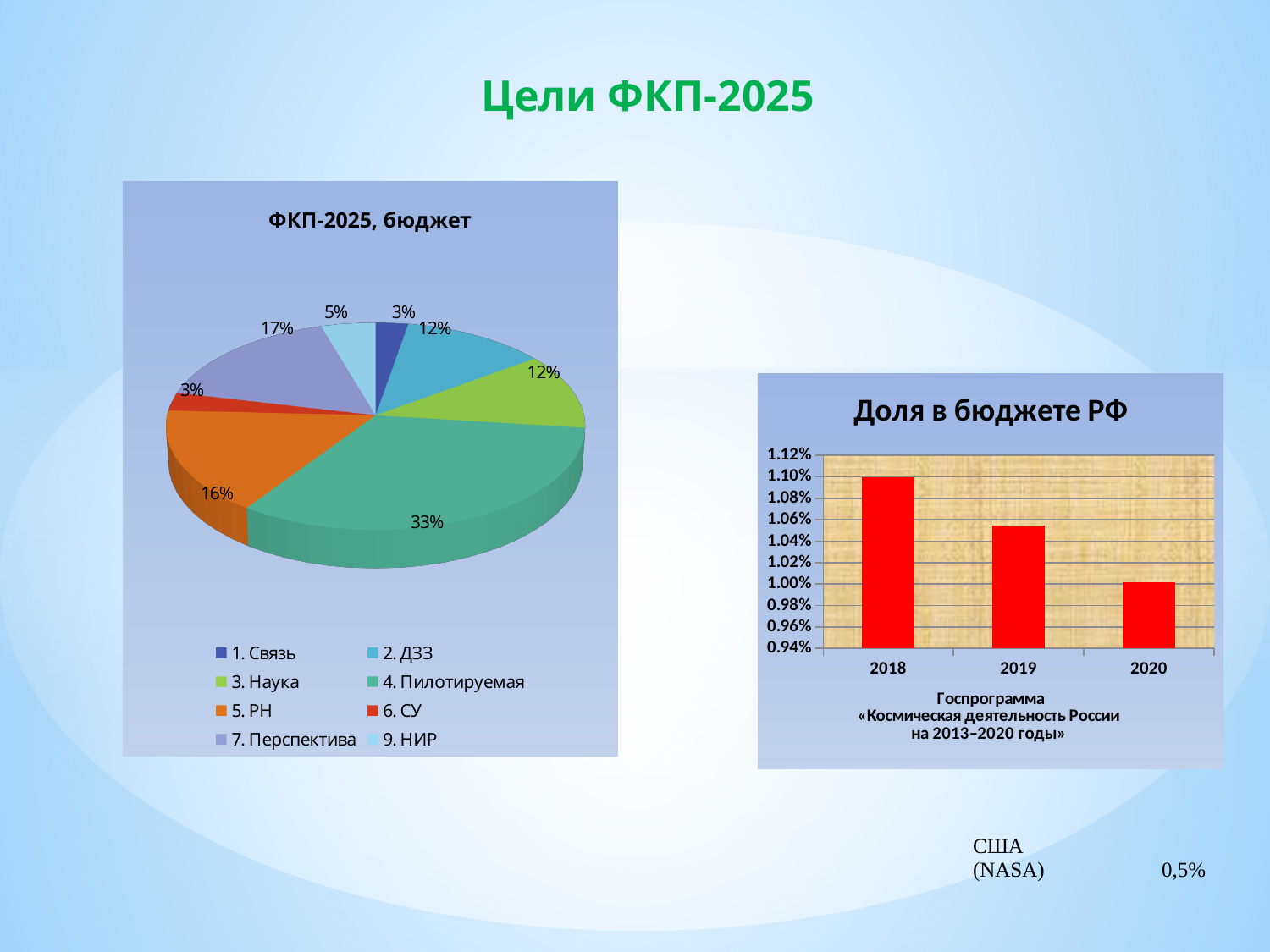
In the chart "Доля в бюджете РФ", what is the value for 2018? 1.10% In the pie chart "ФКП-2025, бюджет", how many categories does the legend list? 8 In the pie chart "ФКП-2025, бюджет", how many percentage points larger is "4. Пилотируемая" than "5. РН"? 17 percentage points In the chart "Доля в бюджете РФ", is the value for 2019 greater or less than 1.04%? greater In the chart "Доля в бюджете РФ", do the values rise or fall from 2018 to 2020? Fall What kind of chart is "ФКП-2025, бюджет"? Pie chart In the pie chart "ФКП-2025, бюджет", what share does "4. Пилотируемая" have? 33% In the chart "Доля в бюджете РФ", which year has the lowest value? 2020 In the pie chart "ФКП-2025, бюджет", what share does "7. Перспектива" have? 17% In the pie chart "ФКП-2025, бюджет", what share does "5. РН" have? 16% In the pie chart "ФКП-2025, бюджет", which category has the largest slice? 4. Пилотируемая What kind of chart is "Доля в бюджете РФ"? Bar chart